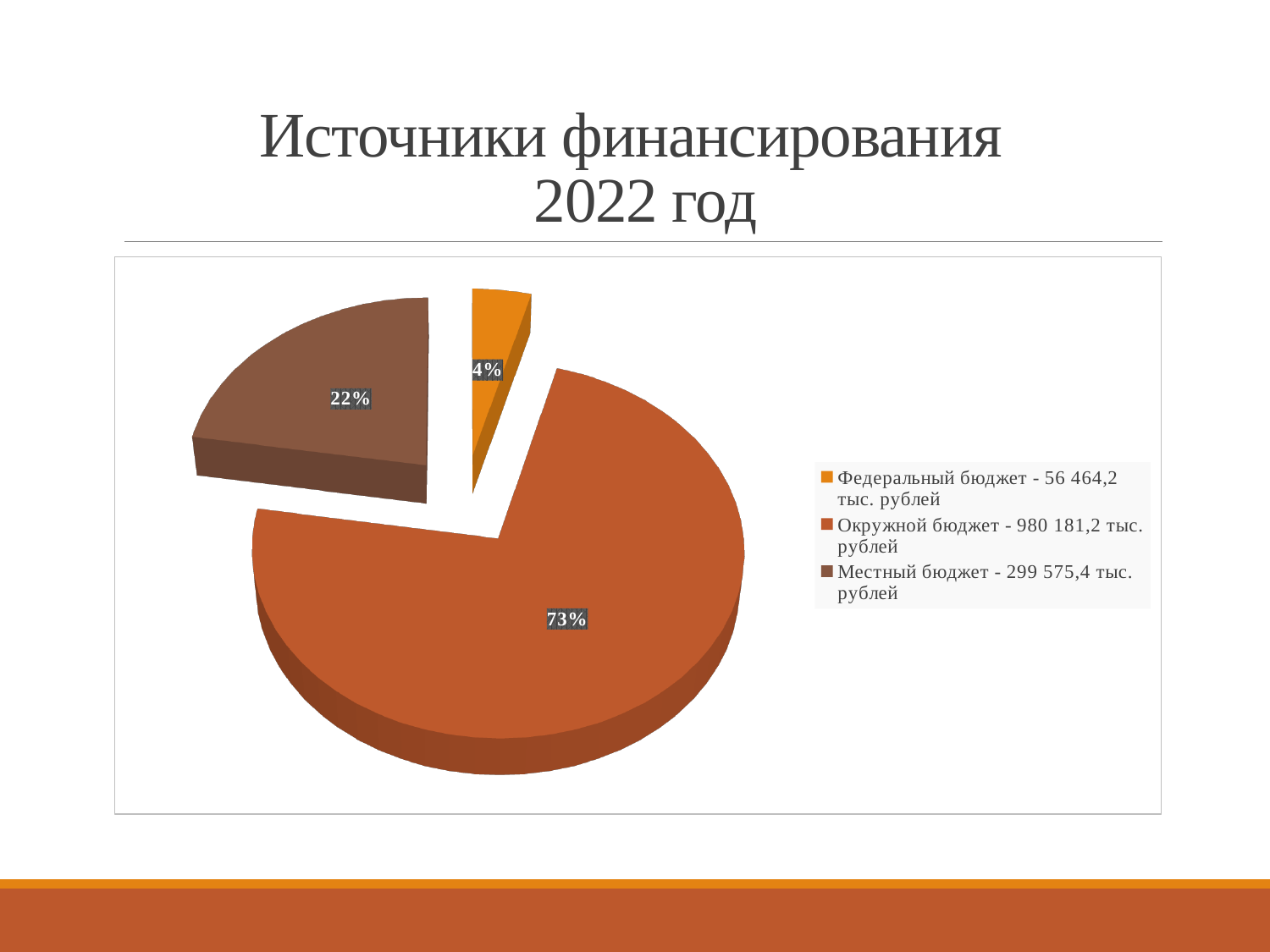
What share of the pie does Окружной бюджет take? 73% What share of the pie does Местный бюджет take? 22% How many slices does the pie chart have? 3 Which funding source has the smallest slice of the pie? Федеральный бюджет What is the title of the slide containing the chart? Источники финансирования 2022 год Which slice is larger: Местный бюджет or Федеральный бюджет? Местный бюджет What kind of chart is shown on the slide? Pie chart Which funding source has the largest slice of the pie? Окружной бюджет What share of the pie does Федеральный бюджет take? 4% How many entries does the legend list? 3 What is the difference in percentage points between the Окружной бюджет slice and the Местный бюджет slice? 51 According to the legend, what amount is given for Окружной бюджет? 980 181,2 тыс. рублей